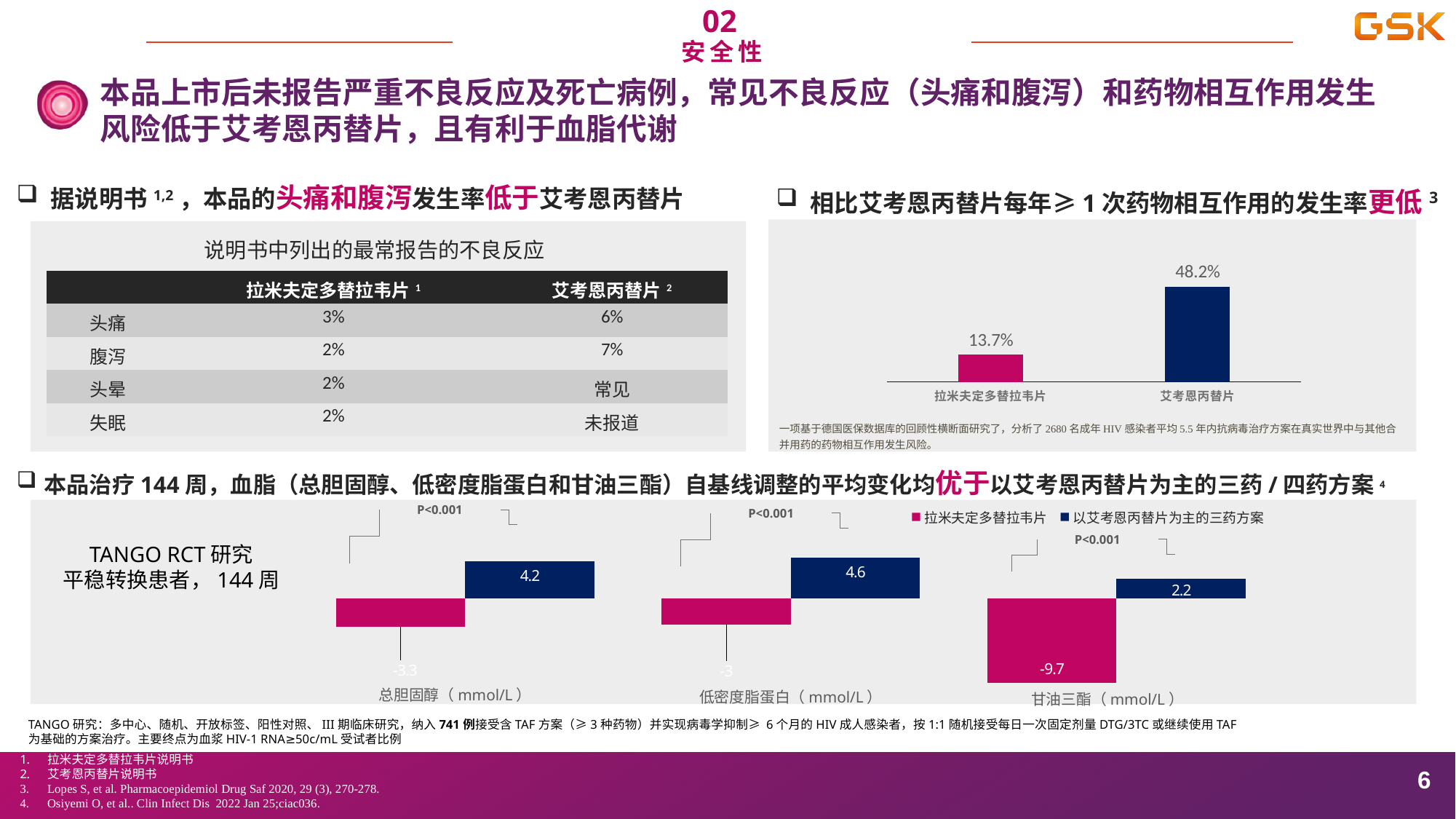
In the top-right chart on drug interaction rates, what is the value for 艾考恩丙替片? 48.2% In the bottom TANGO RCT chart, what is the difference between the 以艾考恩丙替片为主的三药方案 value and the 拉米夫定多替拉韦片 value in the 甘油三酯 category? 11.9 In the top-right chart on drug interaction rates, which category has the higher value? 艾考恩丙替片 In the top-right chart on drug interaction rates, how many bars are plotted? 2 In the bottom TANGO RCT chart, which category has the lowest value for 拉米夫定多替拉韦片? 甘油三酯 In the top-right chart on drug interaction rates, what is the value for 拉米夫定多替拉韦片? 13.7% What kind of chart is the top-right chart on drug interaction rates? Bar chart In the bottom TANGO RCT chart, how many series does the legend list? 2 In the top-right chart on drug interaction rates, what is the difference between the values for 艾考恩丙替片 and 拉米夫定多替拉韦片? 34.5% In the bottom TANGO RCT chart, what is the value for 以艾考恩丙替片为主的三药方案 in the 低密度脂蛋白 category? 4.6 In the bottom TANGO RCT chart, what is the value for 拉米夫定多替拉韦片 in the 甘油三酯 category? -9.7 In the bottom TANGO RCT chart, what is the value for 拉米夫定多替拉韦片 in the 总胆固醇 category? -3.3